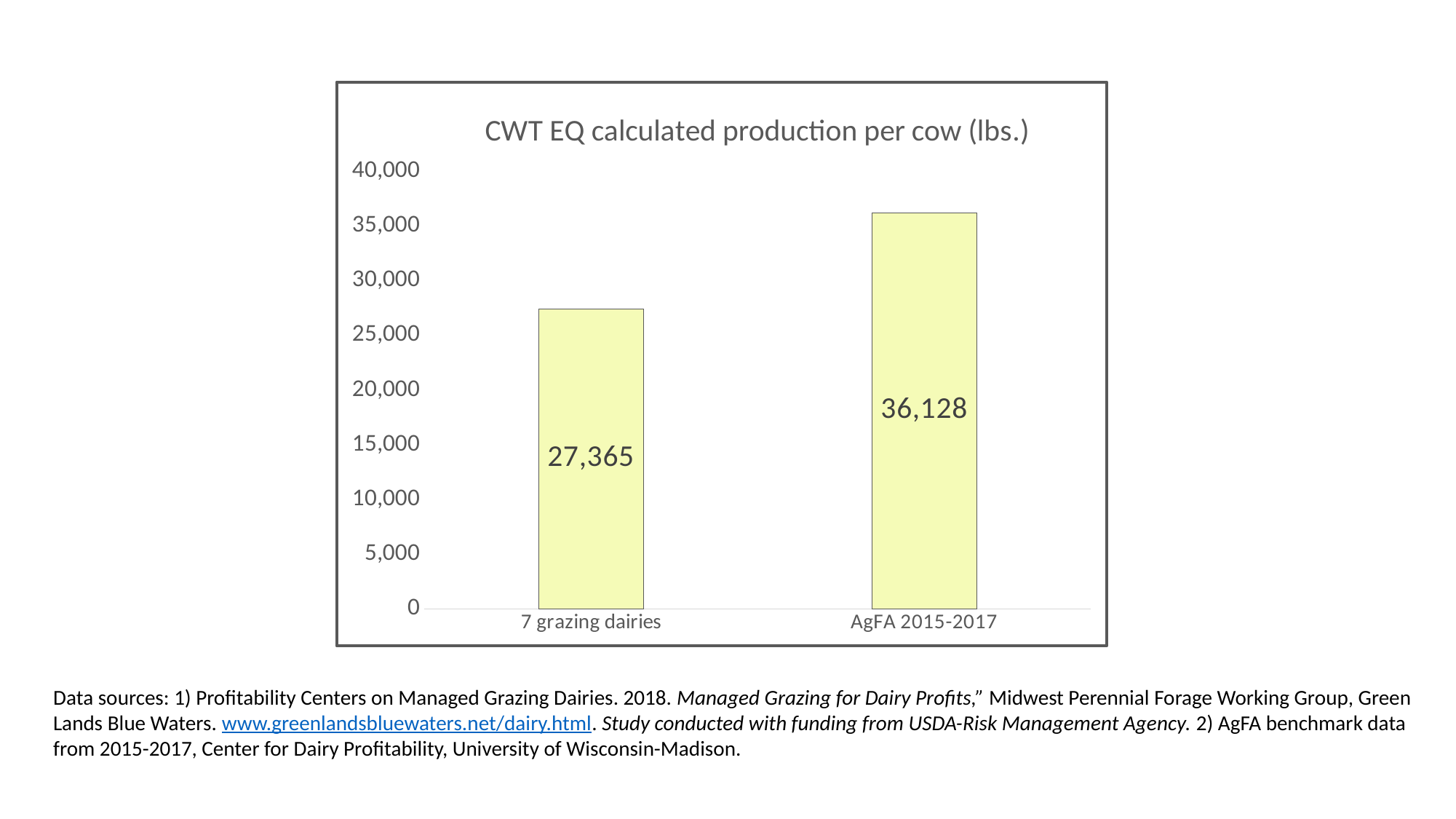
What is the maximum value shown on the vertical axis? 40,000 Which category has the lower CWT EQ calculated production per cow? 7 grazing dairies What is the title of the chart? CWT EQ calculated production per cow (lbs.) What is the CWT EQ calculated production per cow for AgFA 2015-2017? 36,128 What kind of chart is shown on the slide? Bar chart What is the difference in production per cow between AgFA 2015-2017 and the 7 grazing dairies? 8,763 Is the production per cow for AgFA 2015-2017 greater or less than 35,000? greater Is the value for the 7 grazing dairies larger or smaller than the value for AgFA 2015-2017? smaller How many categories are shown in the chart? 2 Is the production per cow for the 7 grazing dairies greater or less than 30,000? less What is the CWT EQ calculated production per cow for the 7 grazing dairies? 27,365 Which category has the higher CWT EQ calculated production per cow? AgFA 2015-2017